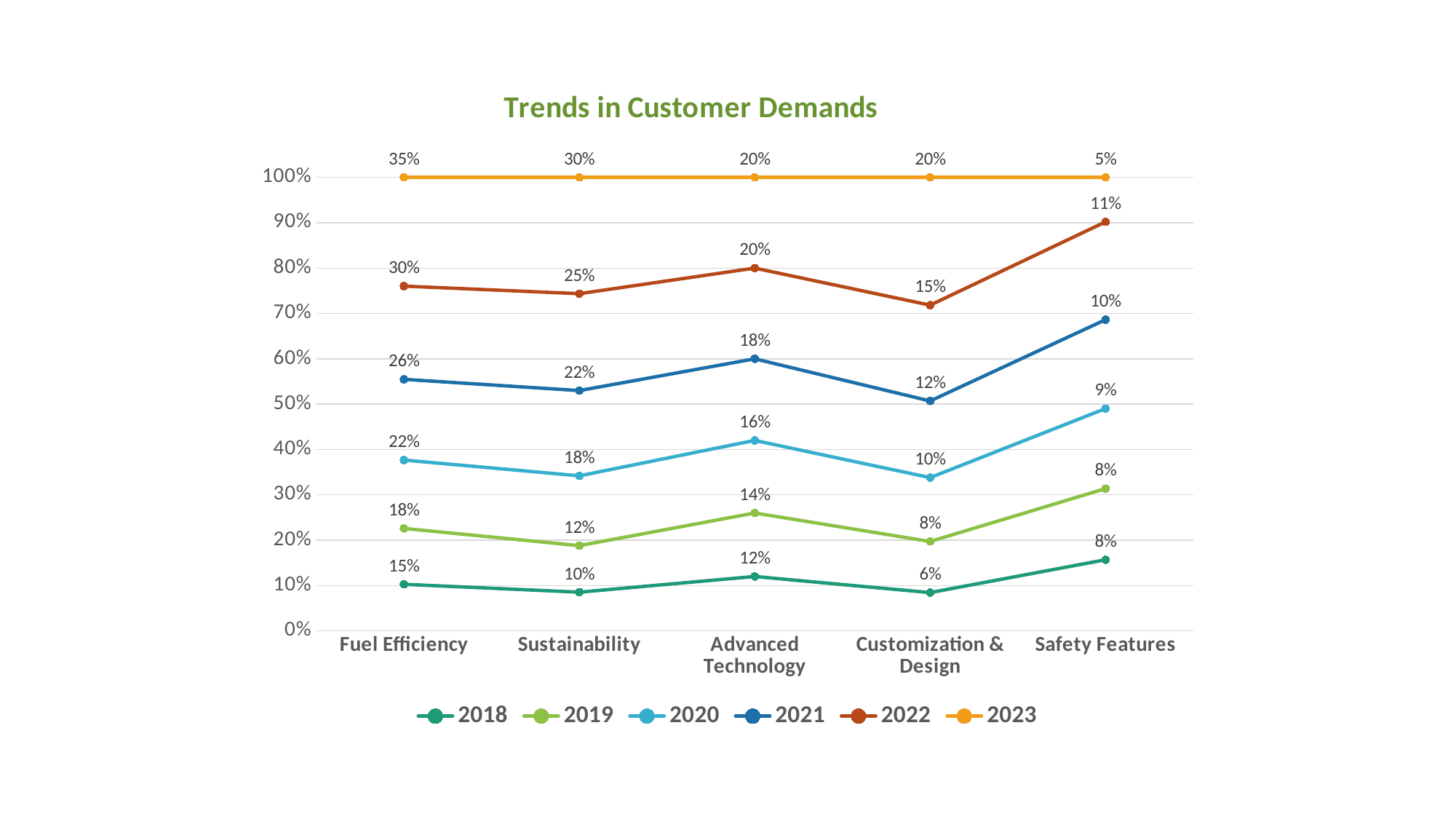
Which is larger, the 2019 value for Sustainability or the 2019 value for Advanced Technology? Advanced Technology What is the 2018 value for Fuel Efficiency? 15% What is the 2023 value for Safety Features? 5% Which category has the highest 2022 value? Fuel Efficiency Which category has the lowest 2018 value? Customization & Design How many categories are shown on the x axis? 5 What is the 2021 value for Advanced Technology? 18% What kind of chart is shown on the slide? Line chart How many series does the legend list? 6 What is the 2020 value for Customization & Design? 10% What is the difference between the 2023 value for Fuel Efficiency and the 2023 value for Sustainability? 5% What is the title of the chart? Trends in Customer Demands